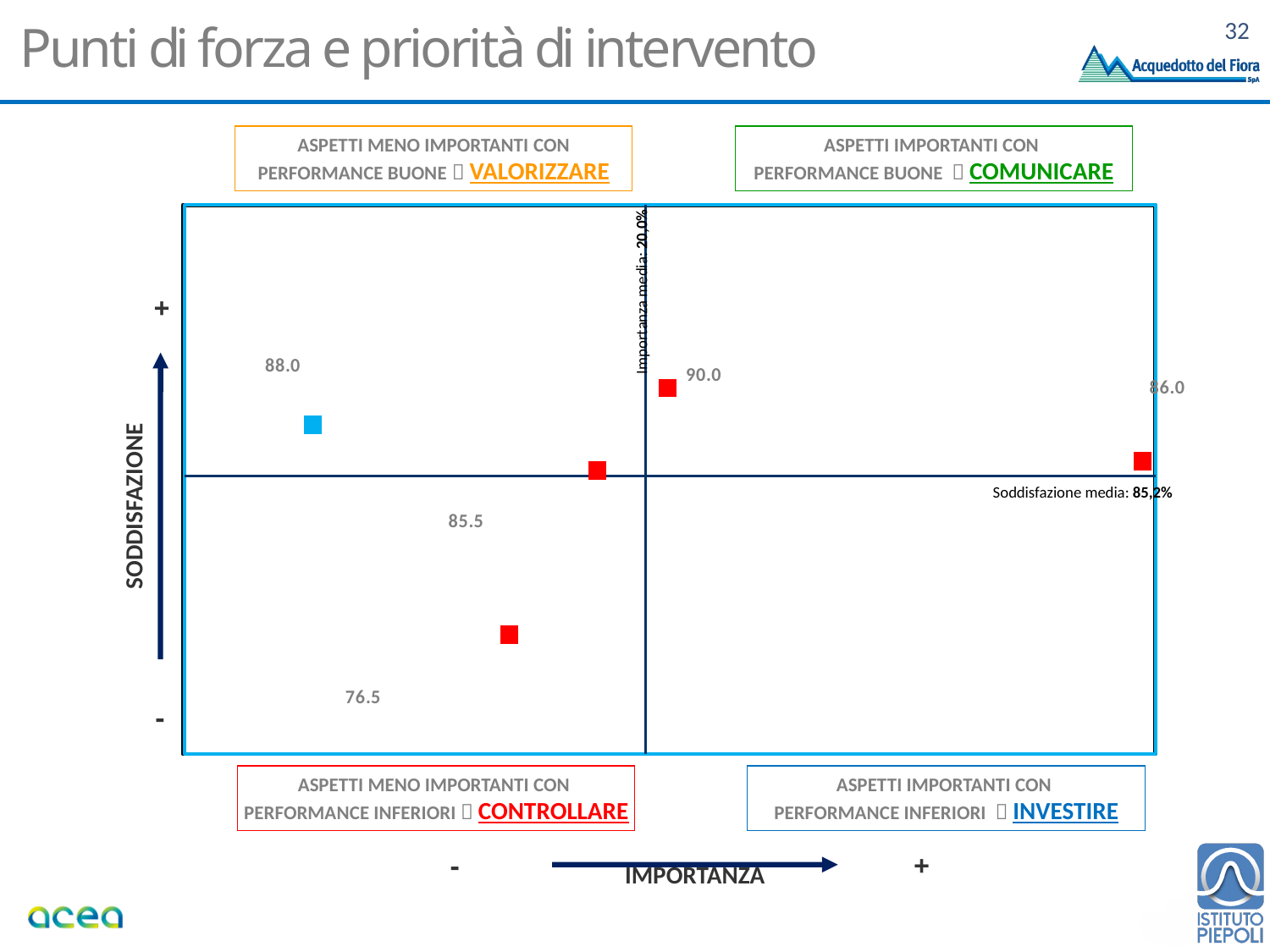
Is the data label 76.5 greater or less than the 'Soddisfazione media' value of 85,2%? less How many data points are plotted on the chart? 5 What is the highest data label shown on the chart? 90.0 What is the difference between the highest data label (90.0) and the lowest data label (76.5) on the chart? 13.5 Which is larger, the data label 88.0 or the data label 85.5? 88.0 What is the lowest data label shown on the chart? 76.5 What is the value of the 'Importanza media' reference line on the chart? 20,0% What is the data label of the blue point on the chart? 88.0 What kind of chart is shown on the slide? scatter chart What is the value of the 'Soddisfazione media' reference line on the chart? 85,2% What is the data label of the point plotted at the far right edge of the chart? 86.0